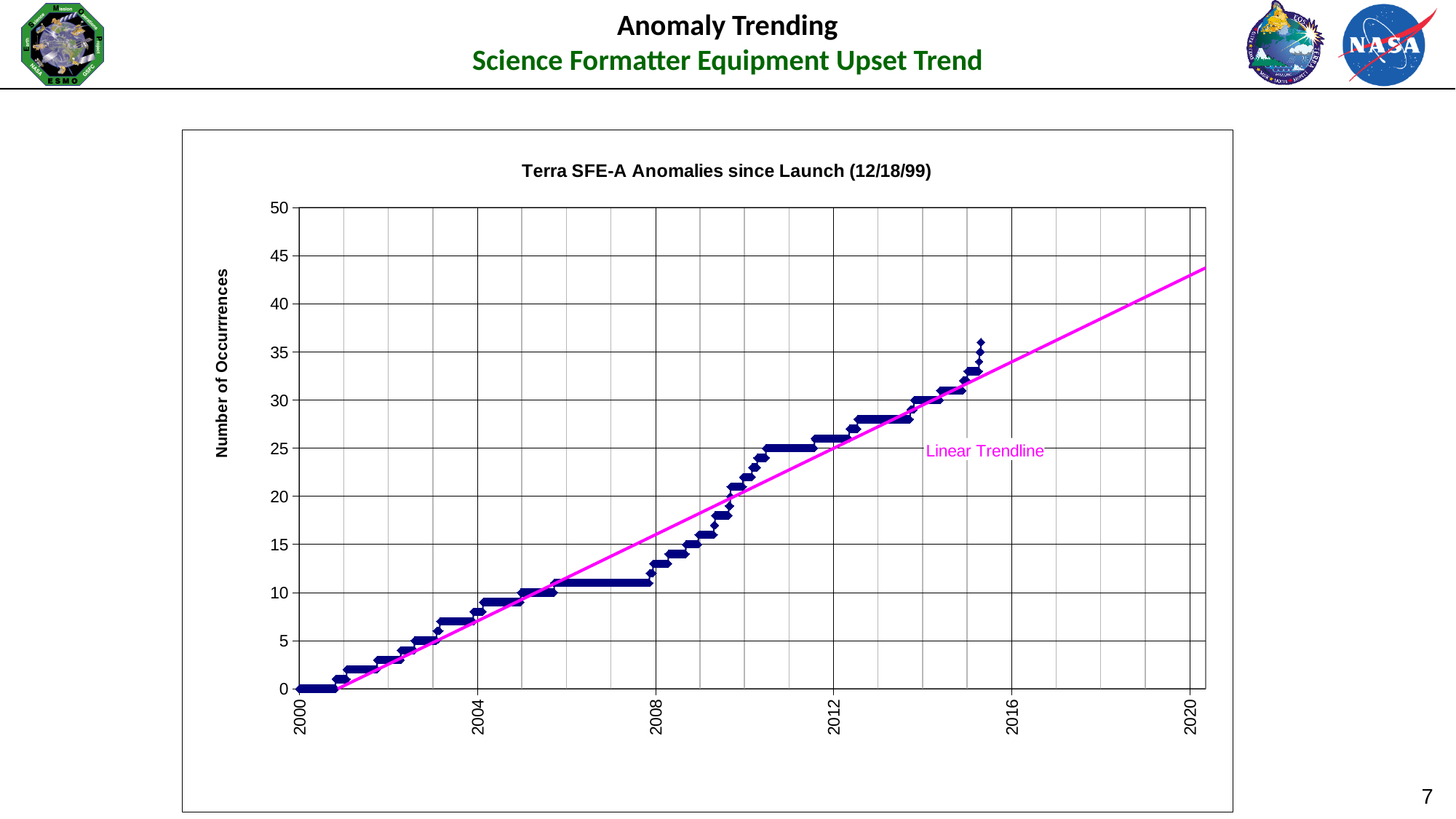
What is the highest value shown on the vertical axis? 50 Is the number of occurrences at the start of 2004 greater or less than 10? less Is the number of occurrences at the start of 2004 greater or less than 5? greater Is the value of the linear trendline at 2020 greater or less than 40? greater Do the plotted values rise or fall as the years increase along the x axis? Rise What is the label of the vertical axis? Number of Occurrrences What kind of chart is shown on the slide? Scatter (line) chart What is the title of the chart? Terra SFE-A Anomalies since Launch (12/18/99) How many year labels are shown along the horizontal axis? 6